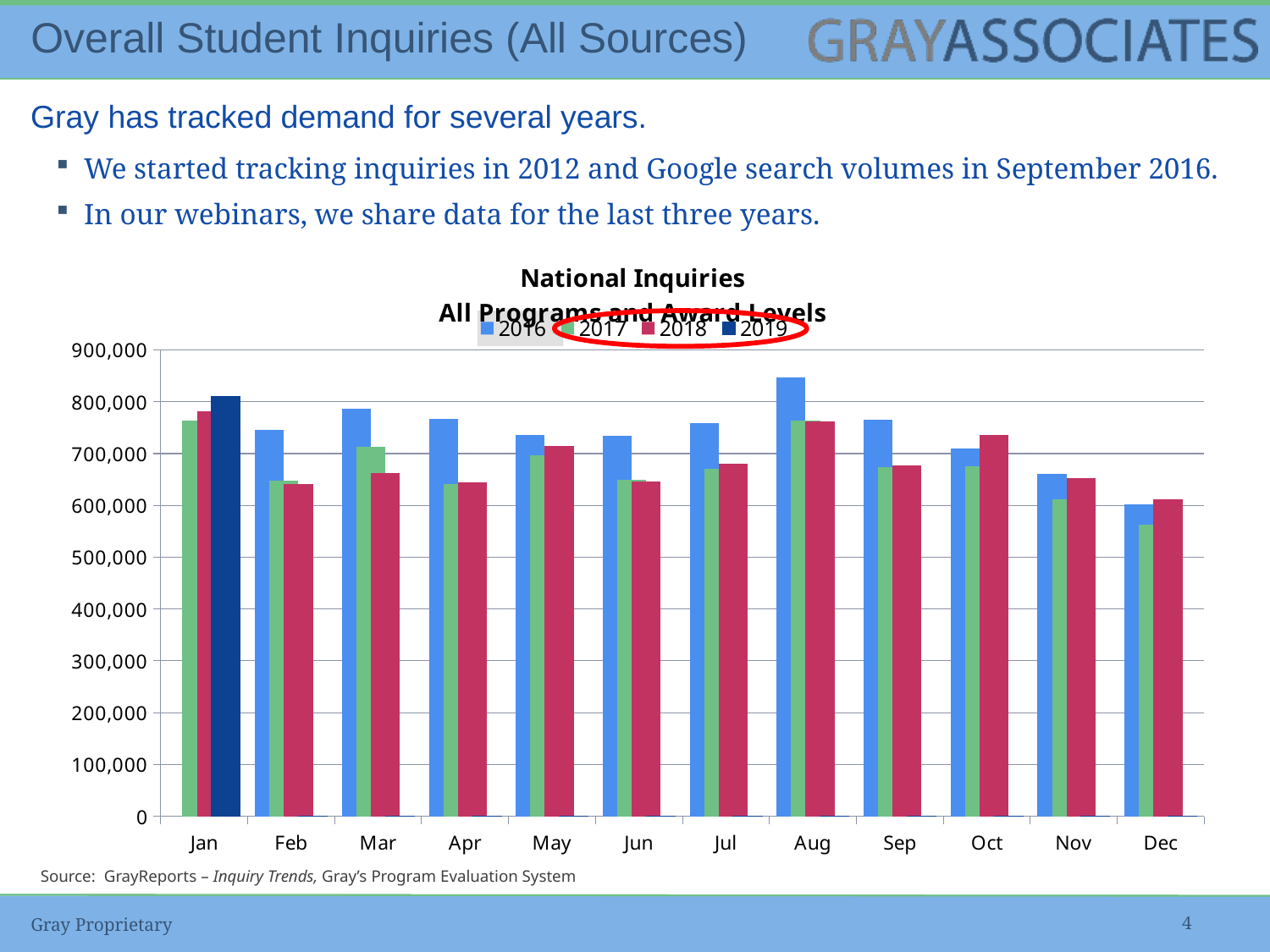
Which month has the highest bar for the 2016 series? Aug How many months are shown along the x axis of the chart? 12 What kind of chart is shown on the slide? bar chart In Jan, which series has the highest bar? 2019 Do the 2016 values rise or fall from Sep to Dec? fall Is the value for 2018 in Feb greater or less than 700,000? less Is the value for 2016 in Aug greater or less than 800,000? greater What is the title of the chart? National Inquiries All Programs and Award Levels Is the value for 2017 in Dec greater or less than 600,000? less How many series does the chart legend list? 4 Which month has the lowest bar for the 2016 series? Dec Which is larger in Mar, the 2017 value or the 2018 value? 2017